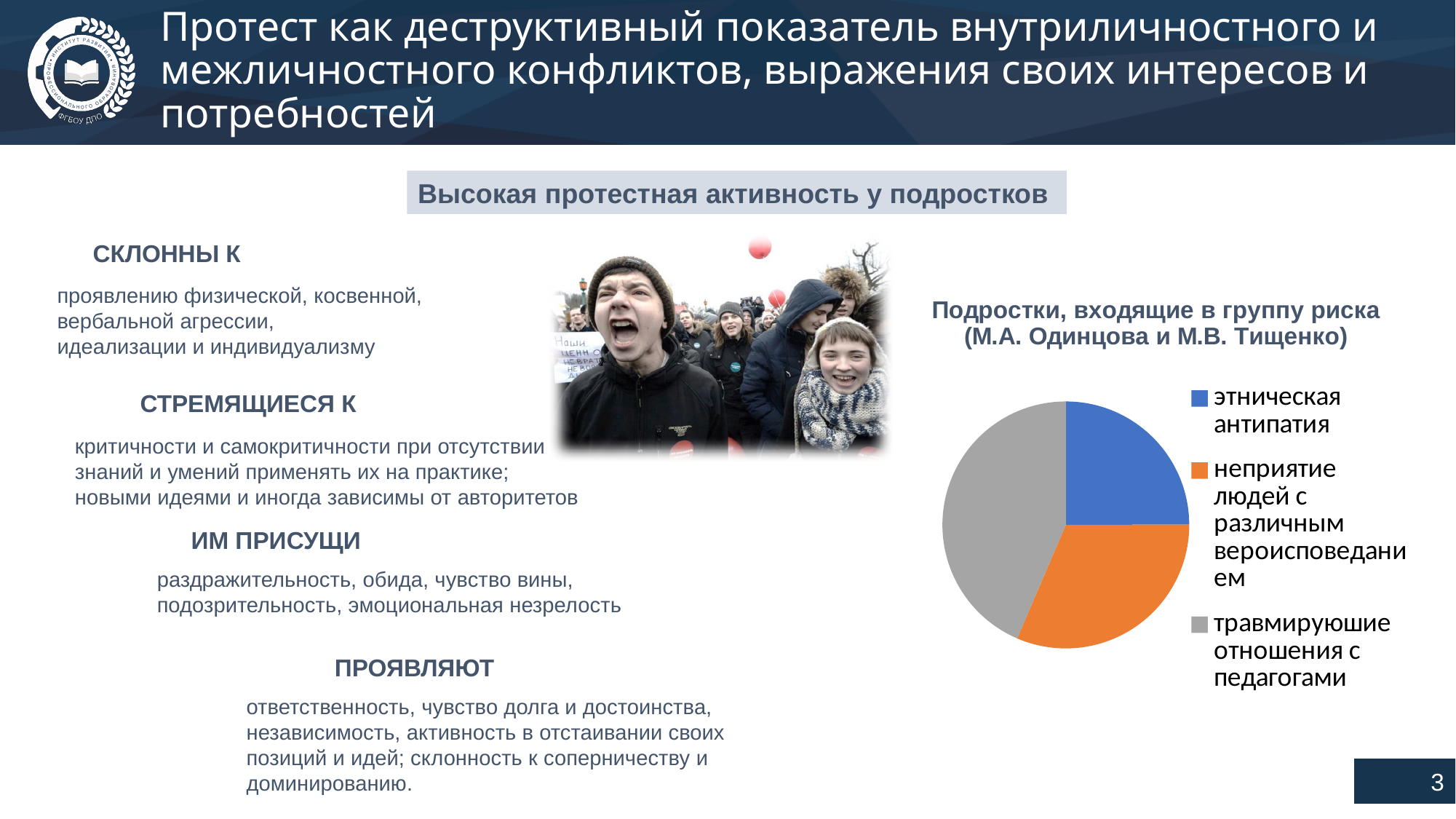
Which slice is larger: 'неприятие людей с различным вероисповеданием' or 'травмируюшие отношения с педагогами'? травмируюшие отношения с педагогами What colour is the slice for 'этническая антипатия' in the pie chart? blue Which slice is larger: 'этническая антипатия' or 'неприятие людей с различным вероисповеданием'? неприятие людей с различным вероисповеданием What is the title of the pie chart? Подростки, входящие в группу риска (М.А. Одинцова и М.В. Тищенко) What kind of chart is shown on the slide? pie chart Which category has the smallest slice in the pie chart? этническая антипатия How many entries does the legend of the pie chart list? 3 Which category has the largest slice in the pie chart? травмируюшие отношения с педагогами How many slices does the pie chart have? 3